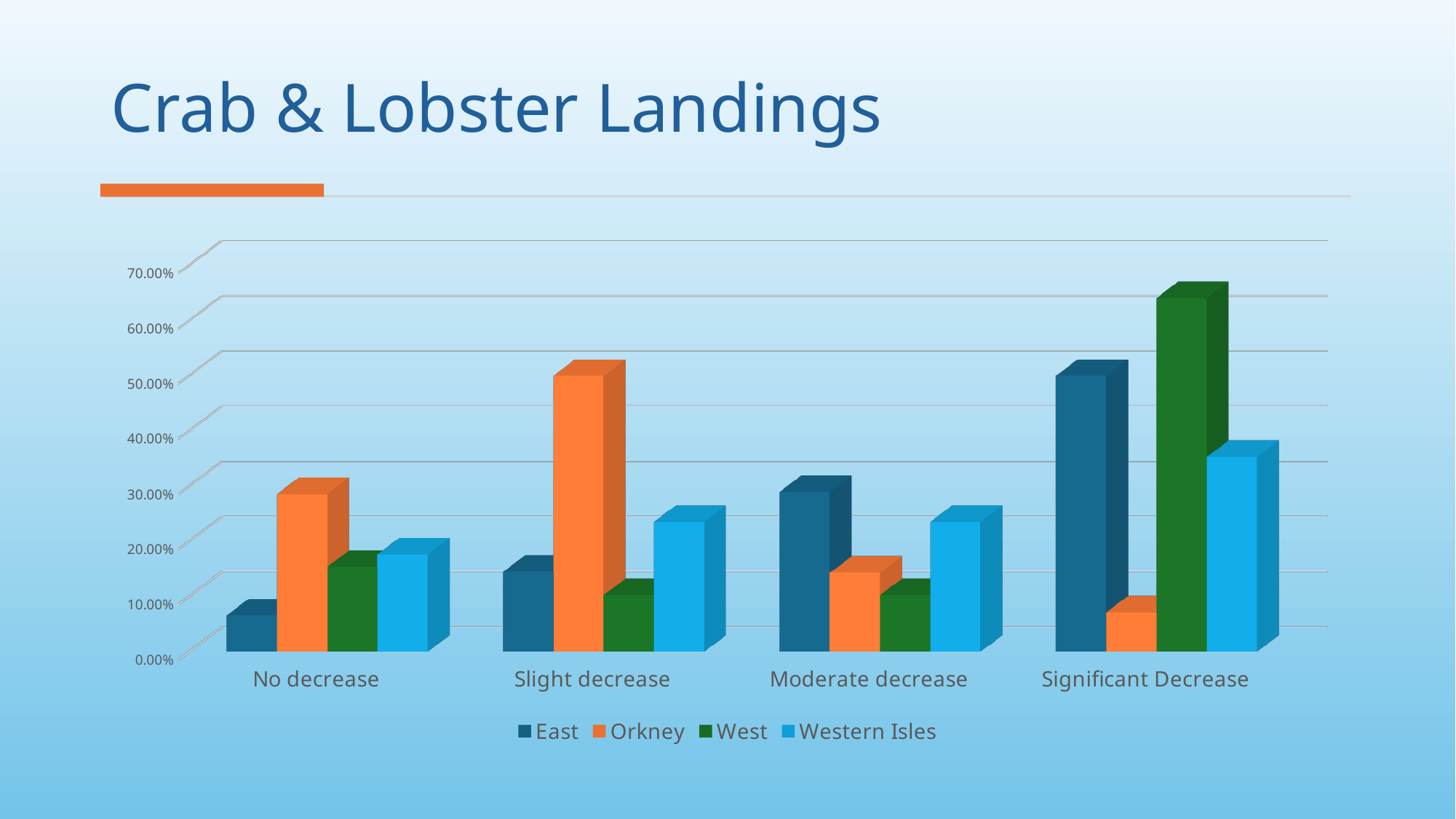
What is the title of the slide containing the chart? Crab & Lobster Landings How many series does the legend list? 4 Which series has the lowest value in the No decrease category? East Is the value for Orkney in the Significant Decrease category greater or less than 20.00%? less Is the Orkney value larger for Slight decrease or for No decrease? Slight decrease Do the East values rise or fall moving from No decrease to Significant Decrease along the x axis? rise Which series has the highest value in the Significant Decrease category? West Which series has the highest value in the Slight decrease category? Orkney How many categories are shown on the x axis of the chart? 4 Is the Western Isles value larger for Significant Decrease or for Moderate decrease? Significant Decrease What kind of chart is shown on the slide? bar chart Is the value for West in the Significant Decrease category greater or less than 50.00%? greater